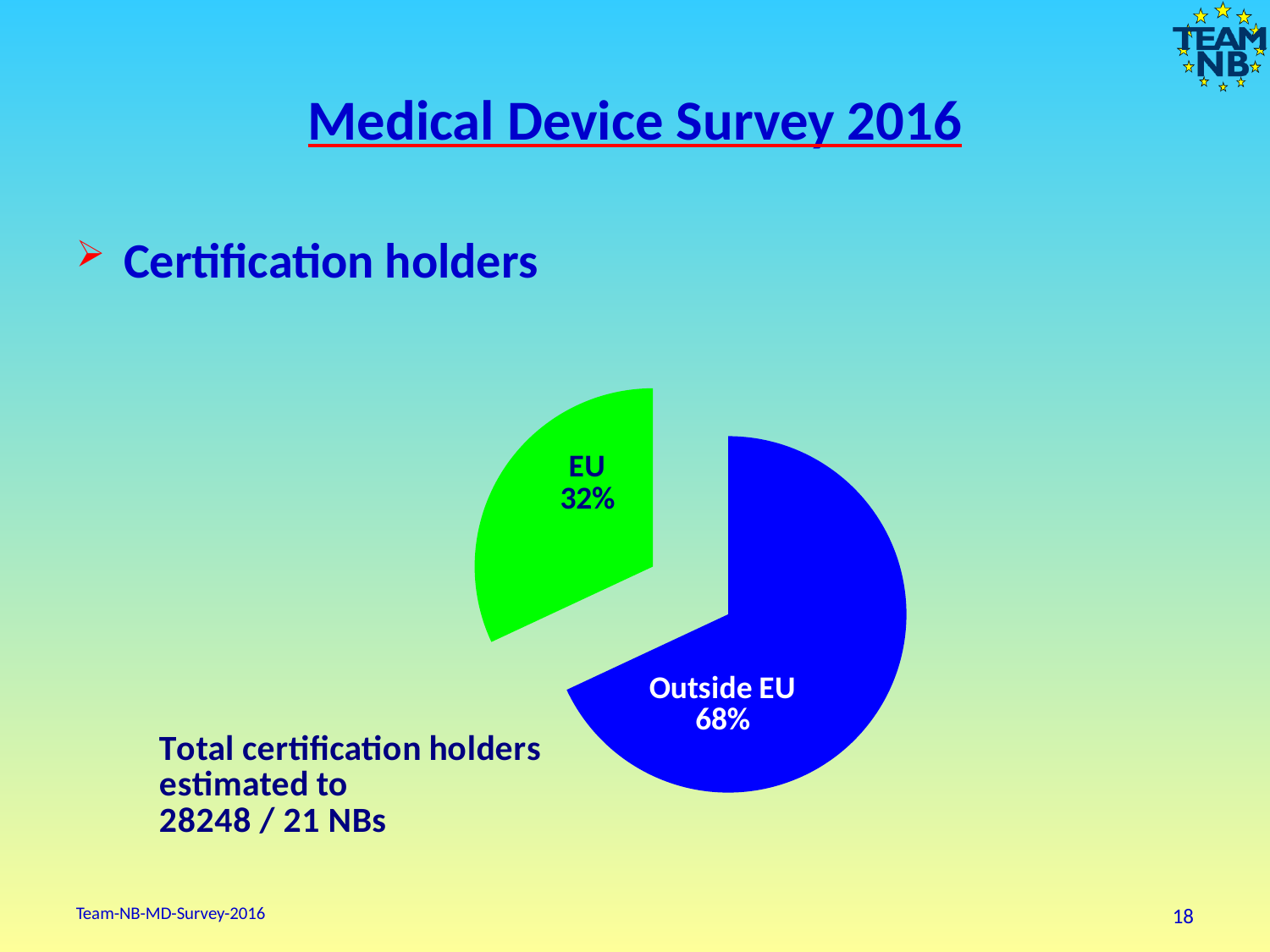
Which slice of the pie is the smallest? EU What is the total number of certification holders estimated on the slide? 28248 What kind of chart is shown on the slide? pie chart Which slice of the pie is the largest? Outside EU How many slices does the pie chart have? 2 What is the difference in percentage points between the Outside EU and EU slices? 36 What share of certification holders is labelled as Outside EU? 68% What share of certification holders is labelled as EU? 32% Which is larger, the EU slice or the Outside EU slice? Outside EU What colour is the Outside EU slice? blue What colour is the EU slice? green